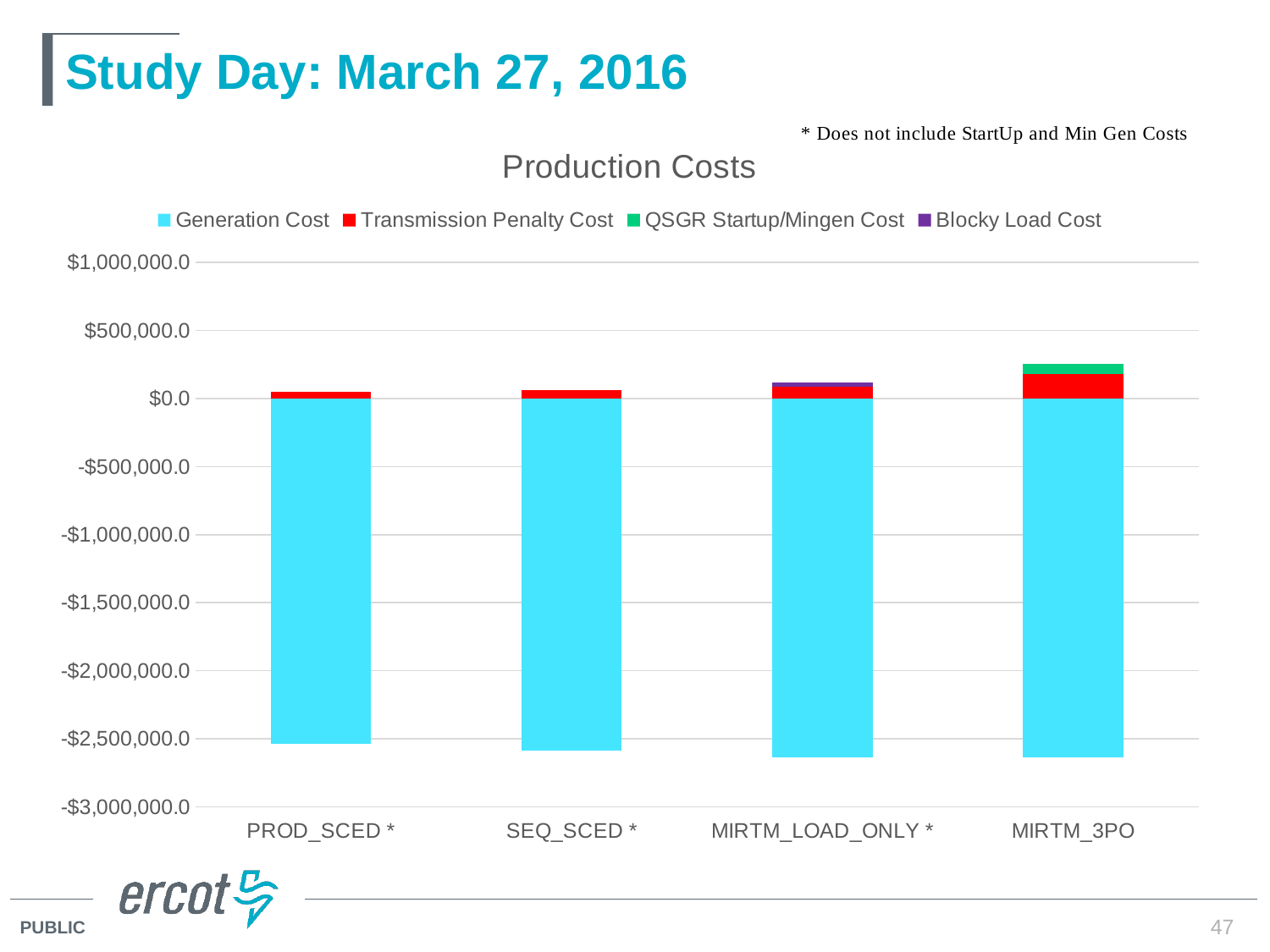
How many categories are shown on the x axis? 4 Are the Generation Cost values positive or negative? negative Which category shows a QSGR Startup/Mingen Cost segment? MIRTM_3PO What is the title of the chart? Production Costs Is the Transmission Penalty Cost for MIRTM_3PO greater or less than $500,000.0? less How many series does the legend list? 4 Which is larger, the Transmission Penalty Cost for MIRTM_3PO or for PROD_SCED *? MIRTM_3PO Is the Generation Cost for PROD_SCED * greater or less than -$2,000,000.0? less Which category has the largest Transmission Penalty Cost? MIRTM_3PO What type of chart is shown on the slide? bar chart Which category shows a Blocky Load Cost segment? MIRTM_LOAD_ONLY *